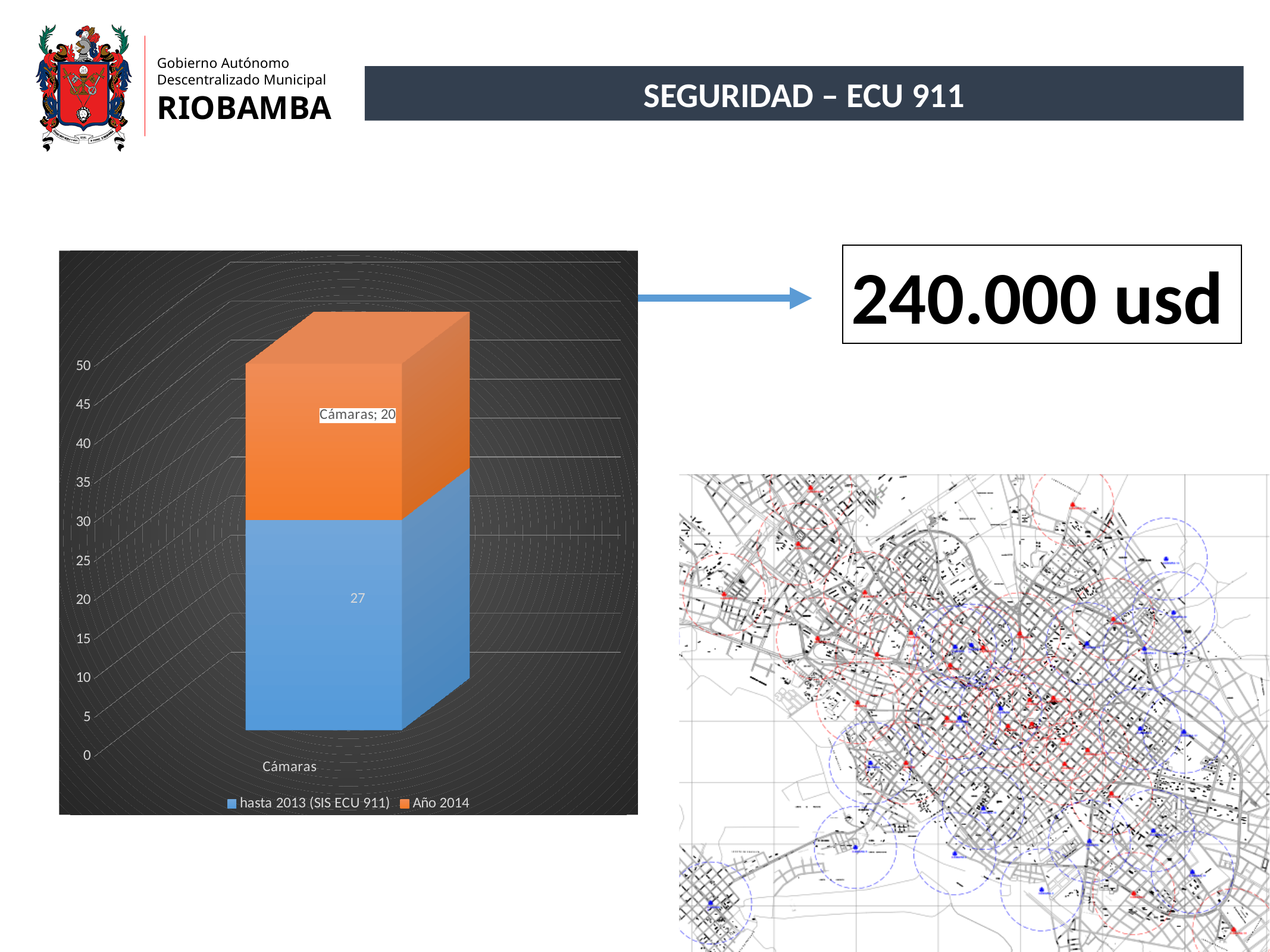
How many series does the legend list? 2 What is the difference between the 'hasta 2013 (SIS ECU 911)' value and the 'Año 2014' value for Cámaras? 7 What kind of chart is shown on the slide? Stacked bar chart How many categories are shown on the x axis of the chart? 1 What is the total of the stacked bar for Cámaras? 47 What is the label of the category on the x axis of the chart? Cámaras Is the total height of the stacked bar for Cámaras greater or less than 40? greater What is the value for the 'hasta 2013 (SIS ECU 911)' series for Cámaras? 27 Which series has the larger value for Cámaras, 'hasta 2013 (SIS ECU 911)' or 'Año 2014'? hasta 2013 (SIS ECU 911) Which series has the smallest value in the chart? Año 2014 What is the value for the 'Año 2014' series for Cámaras? 20 What colour represents the 'Año 2014' series in the chart? Orange